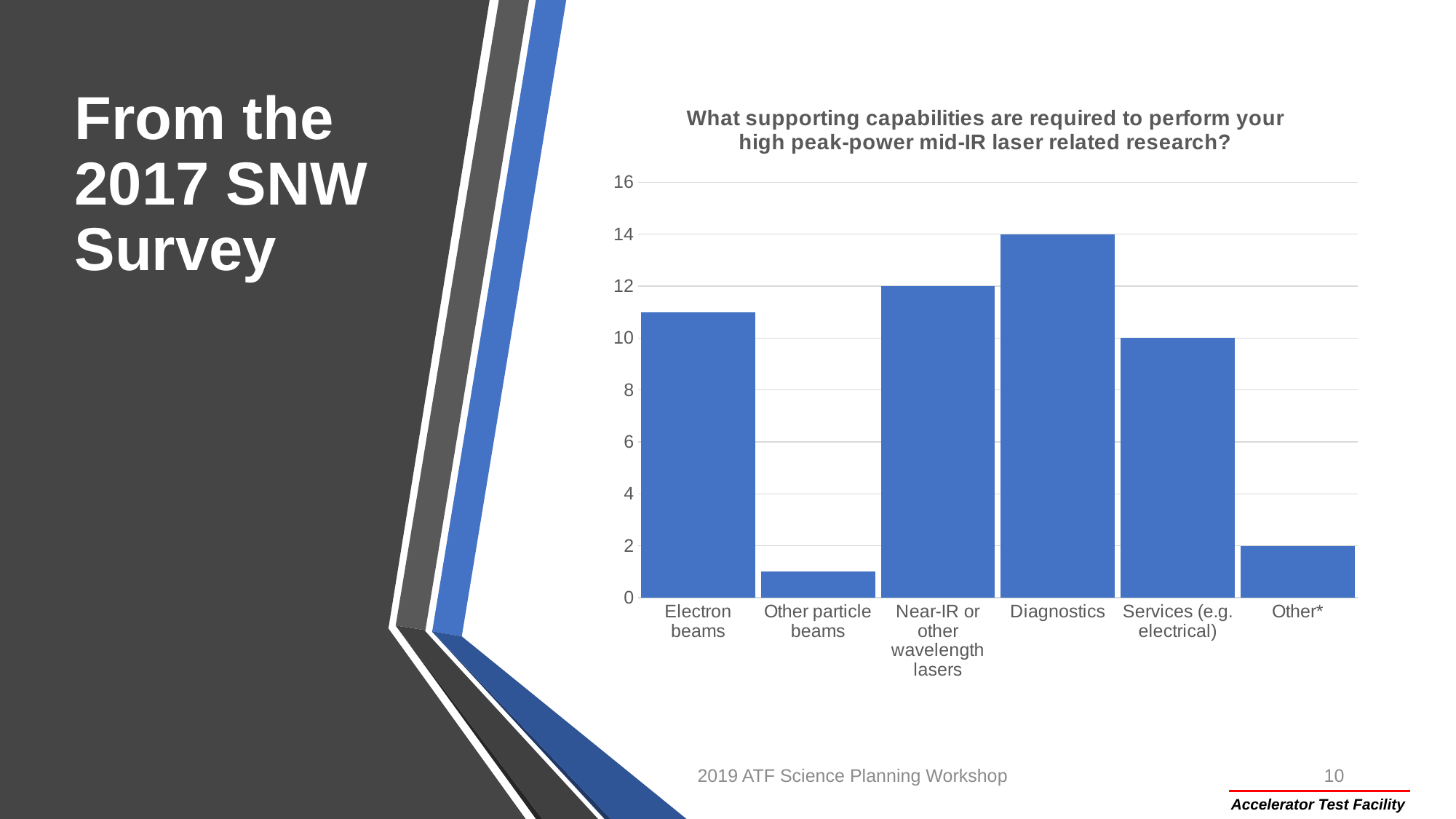
What is the value for Near-IR or other wavelength lasers? 12 What type of chart is shown on the slide? Bar chart What is the title of the chart? What supporting capabilities are required to perform your high peak-power mid-IR laser related research? Which is larger, the value for Near-IR or other wavelength lasers or the value for Services (e.g. electrical)? Near-IR or other wavelength lasers What is the value for Diagnostics? 14 What is the value for Other*? 2 Which category has the lowest value in the chart? Other particle beams What is the value for Services (e.g. electrical)? 10 How many categories are shown on the x axis of the chart? 6 What is the difference between the values for Diagnostics and Services (e.g. electrical)? 4 Which category has the highest value in the chart? Diagnostics Is the value for Electron beams greater or less than 10? greater